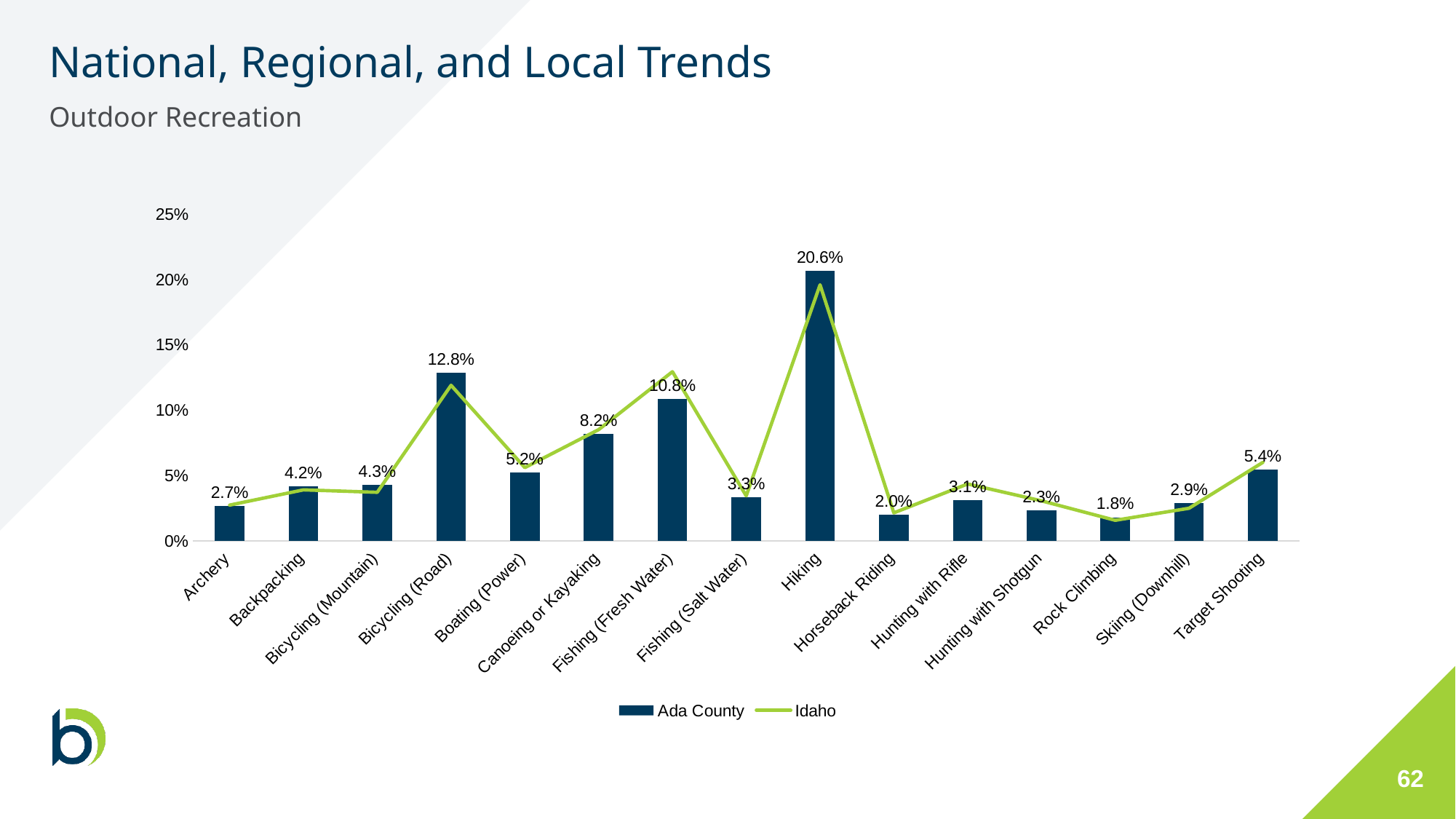
Which category has the lowest Ada County value? Rock Climbing What is the Ada County value for Hiking? 20.6% What is the Ada County value for Bicycling (Road)? 12.8% Is the Idaho value for Hiking greater or less than 15%? greater Which category has the highest Ada County value? Hiking What is the Ada County value for Rock Climbing? 1.8% Is the Idaho value for Horseback Riding greater or less than 5%? less What is the difference between the Ada County values for Hiking and Bicycling (Road)? 7.8% Which has a larger Ada County value, Fishing (Fresh Water) or Canoeing or Kayaking? Fishing (Fresh Water) How many series does the legend list? 2 Which series is drawn as a line rather than bars? Idaho How many activity categories are shown on the x axis? 15